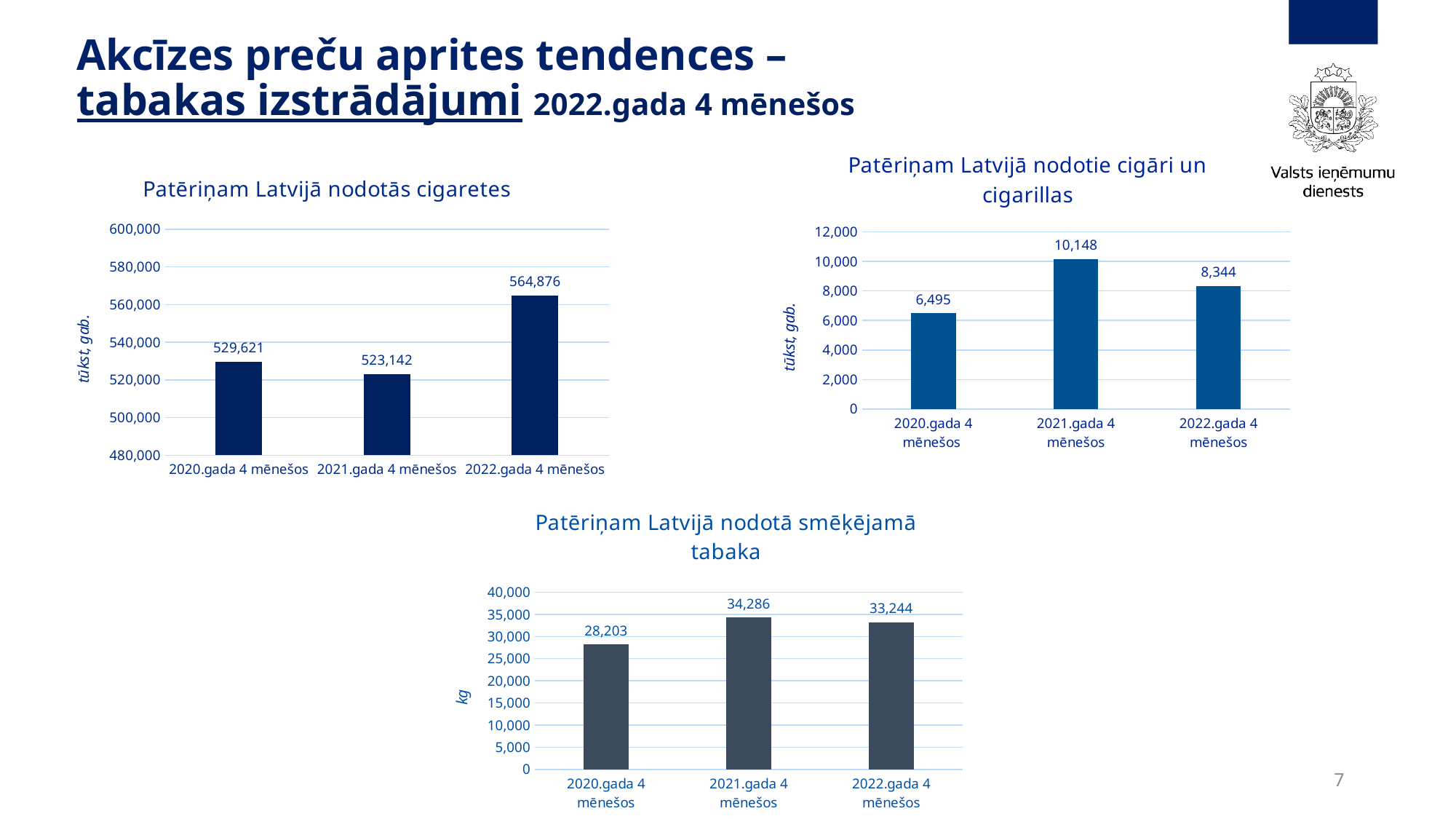
In the chart 'Patēriņam Latvijā nodotās cigaretes', is the value for 2020.gada 4 mēnešos greater or less than 540,000? less What is the y-axis unit label on the chart 'Patēriņam Latvijā nodotā smēķējamā tabaka'? kg In the chart 'Patēriņam Latvijā nodotās cigaretes', what is the difference between the 2022.gada 4 mēnešos and 2021.gada 4 mēnešos values? 41,734 In the chart 'Patēriņam Latvijā nodotās cigaretes', what is the value for 2022.gada 4 mēnešos? 564,876 In the chart 'Patēriņam Latvijā nodotā smēķējamā tabaka', which is larger: the value for 2021.gada 4 mēnešos or 2022.gada 4 mēnešos? 2021.gada 4 mēnešos In the chart 'Patēriņam Latvijā nodotā smēķējamā tabaka', how many periods are shown? 3 In the chart 'Patēriņam Latvijā nodotie cigāri un cigarillas', what is the difference between the 2021.gada 4 mēnešos and 2020.gada 4 mēnešos values? 3,653 In the chart 'Patēriņam Latvijā nodotā smēķējamā tabaka', what is the value for 2020.gada 4 mēnešos? 28,203 What kind of chart is 'Patēriņam Latvijā nodotā smēķējamā tabaka'? Bar chart In the chart 'Patēriņam Latvijā nodotie cigāri un cigarillas', which period has the highest value? 2021.gada 4 mēnešos In the chart 'Patēriņam Latvijā nodotās cigaretes', which period has the lowest value? 2021.gada 4 mēnešos In the chart 'Patēriņam Latvijā nodotie cigāri un cigarillas', what is the value for 2021.gada 4 mēnešos? 10,148